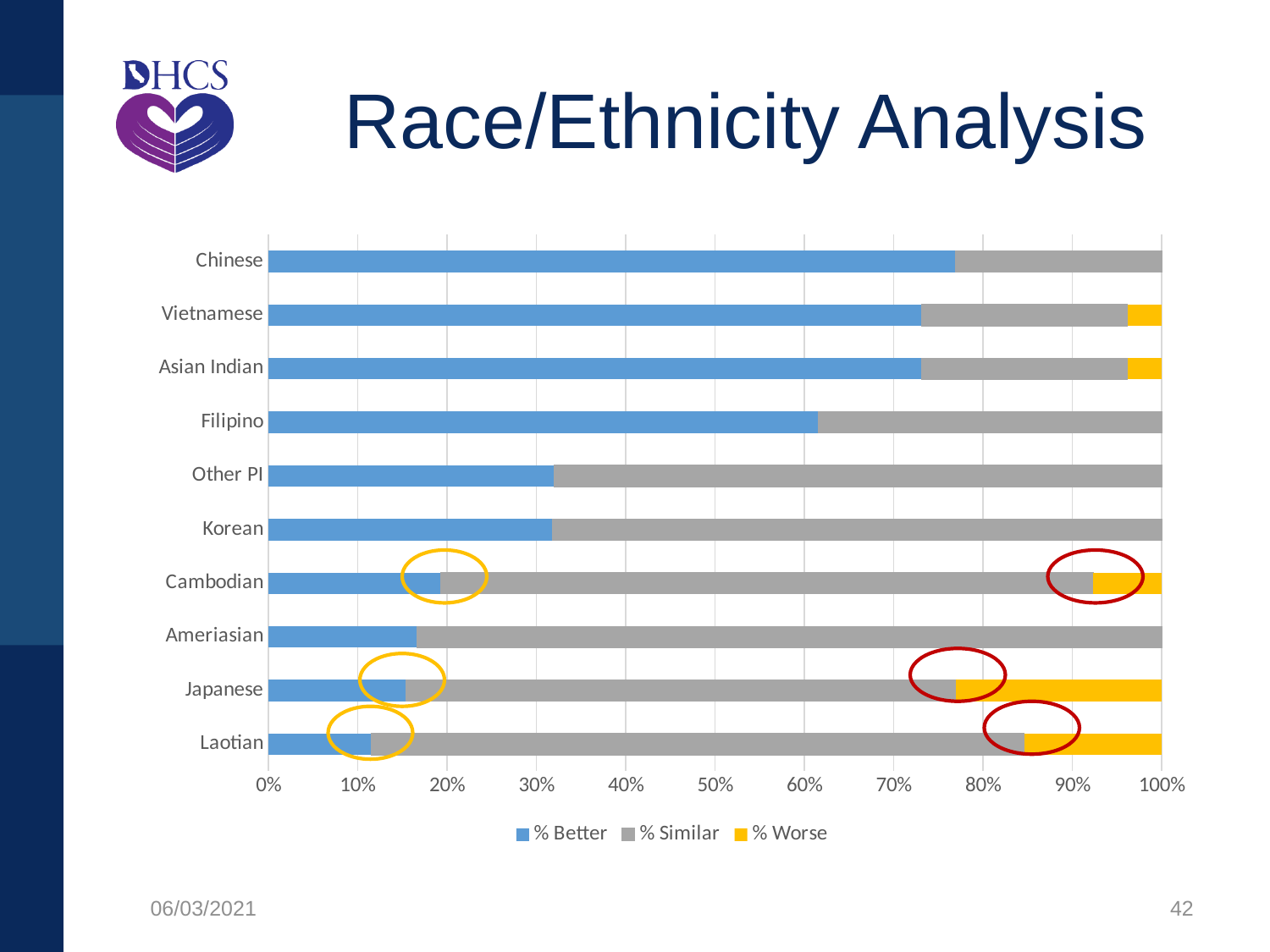
Which colour represents the % Worse series in the chart? Yellow Is the % Better value for Chinese greater or less than 70%? greater How many series does the chart legend list? 3 Which has a larger % Worse value, Japanese or Cambodian? Japanese How many race/ethnicity categories are plotted in the chart? 10 Which race/ethnicity category has the lowest % Better value? Laotian Is the % Better value for Other PI greater or less than 40%? less Which race/ethnicity category has the highest % Worse value? Japanese Is the % Better value for Laotian greater or less than 20%? less What is the title of the chart on the slide? Race/Ethnicity Analysis Which race/ethnicity category has the highest % Better value? Chinese What kind of chart is shown on the slide? Stacked bar chart